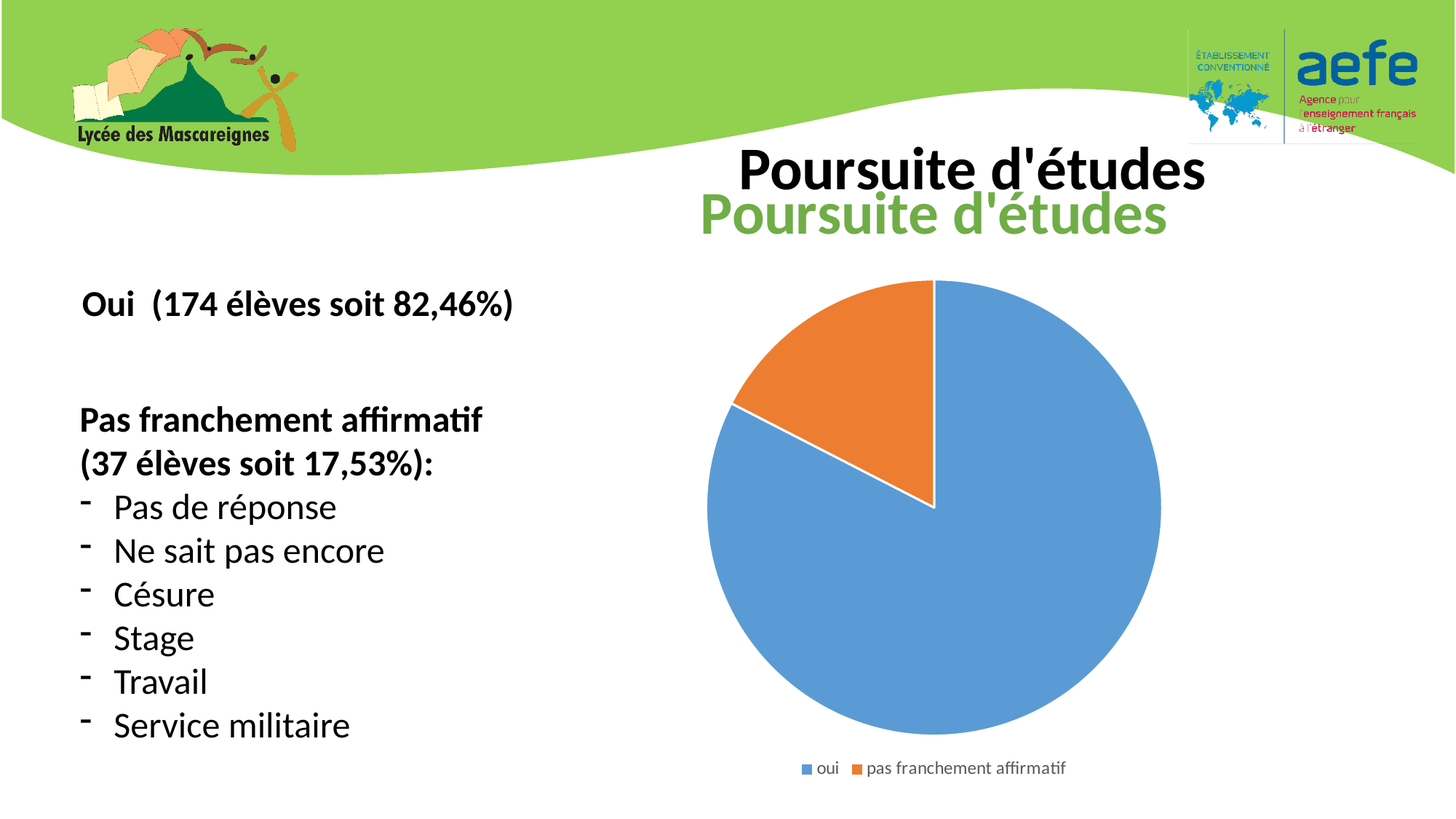
How many students does the 'pas franchement affirmatif' slice correspond to, according to the slide? 37 What is the title of the chart? Poursuite d'études What kind of chart is shown on the slide? pie chart How many students does the 'oui' slice correspond to, according to the slide? 174 How many entries does the chart legend list? 2 Which is larger in the pie chart, 'oui' or 'pas franchement affirmatif'? oui What share of the pie does the 'pas franchement affirmatif' slice represent, according to the slide? 17,53% What colour is the 'oui' slice in the pie chart? blue What share of the pie does the 'oui' slice represent, according to the slide? 82,46% Which slice of the pie chart is the smallest? pas franchement affirmatif How many slices does the pie chart have? 2 Which slice of the pie chart is the largest? oui